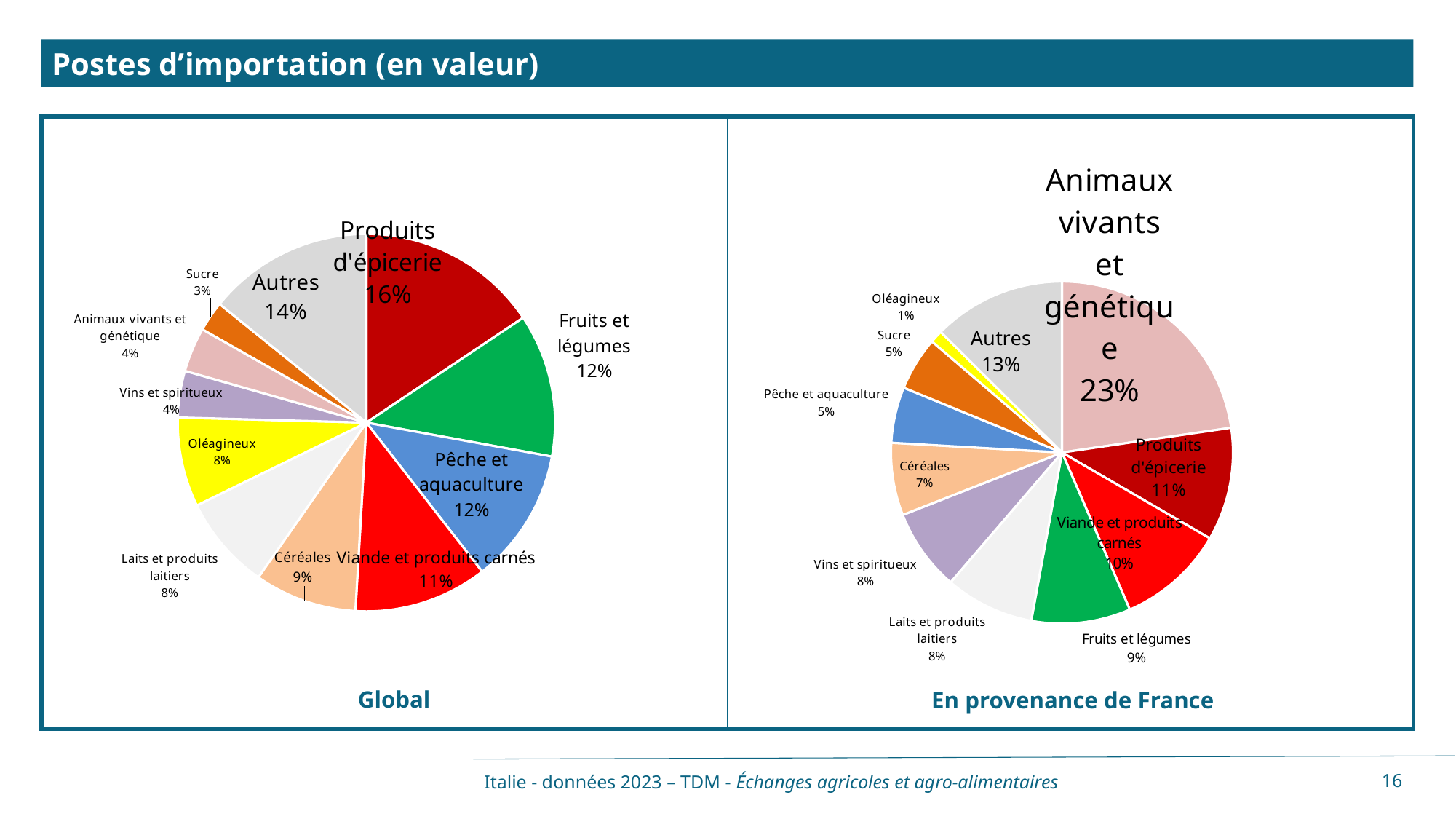
In the Global chart, which is larger: the share of Céréales or the share of Oléagineux? Céréales In the Global chart, what share do Produits d'épicerie represent? 16% In the En provenance de France chart, which is larger: the share of Céréales or the share of Fruits et légumes? Fruits et légumes In the En provenance de France chart, what share do Animaux vivants et génétique represent? 23% How many categories are shown in the Global pie chart? 11 In the Global chart, which category has the largest share? Produits d'épicerie What type of chart is used in the En provenance de France panel? Pie chart In the Global chart, what is the difference between the shares of Produits d'épicerie and Viande et produits carnés? 5 percentage points In the En provenance de France chart, what is the difference between the shares of Animaux vivants et génétique and Produits d'épicerie? 12 percentage points In the En provenance de France chart, which category has the smallest share? Oléagineux In the Global chart, which category has the smallest share? Sucre In the En provenance de France chart, what share does Pêche et aquaculture represent? 5%